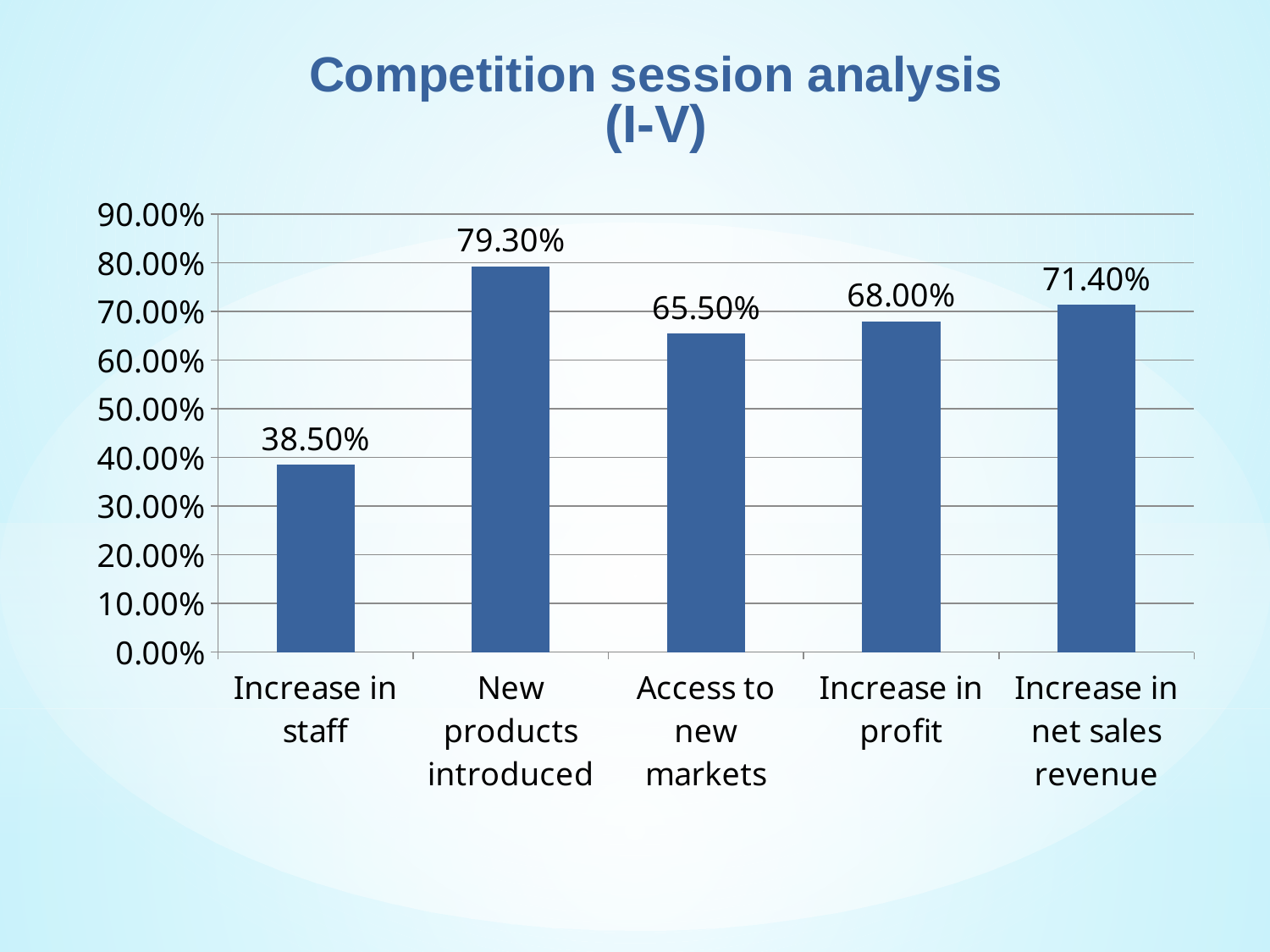
What is the difference between the values for Increase in net sales revenue and Increase in profit? 3.40% Which category has the lowest value? Increase in staff Which is larger, the value for Increase in profit or the value for Access to new markets? Increase in profit Which category has the highest value? New products introduced What is the value for Access to new markets? 65.50% What is the title of the slide? Competition session analysis (I-V) What is the value for Increase in net sales revenue? 71.40% What is the difference between the values for New products introduced and Increase in staff? 40.80% What is the value for New products introduced? 79.30% How many categories are shown on the chart? 5 What is the value for Increase in staff? 38.50% What kind of chart is shown on the slide? Bar chart